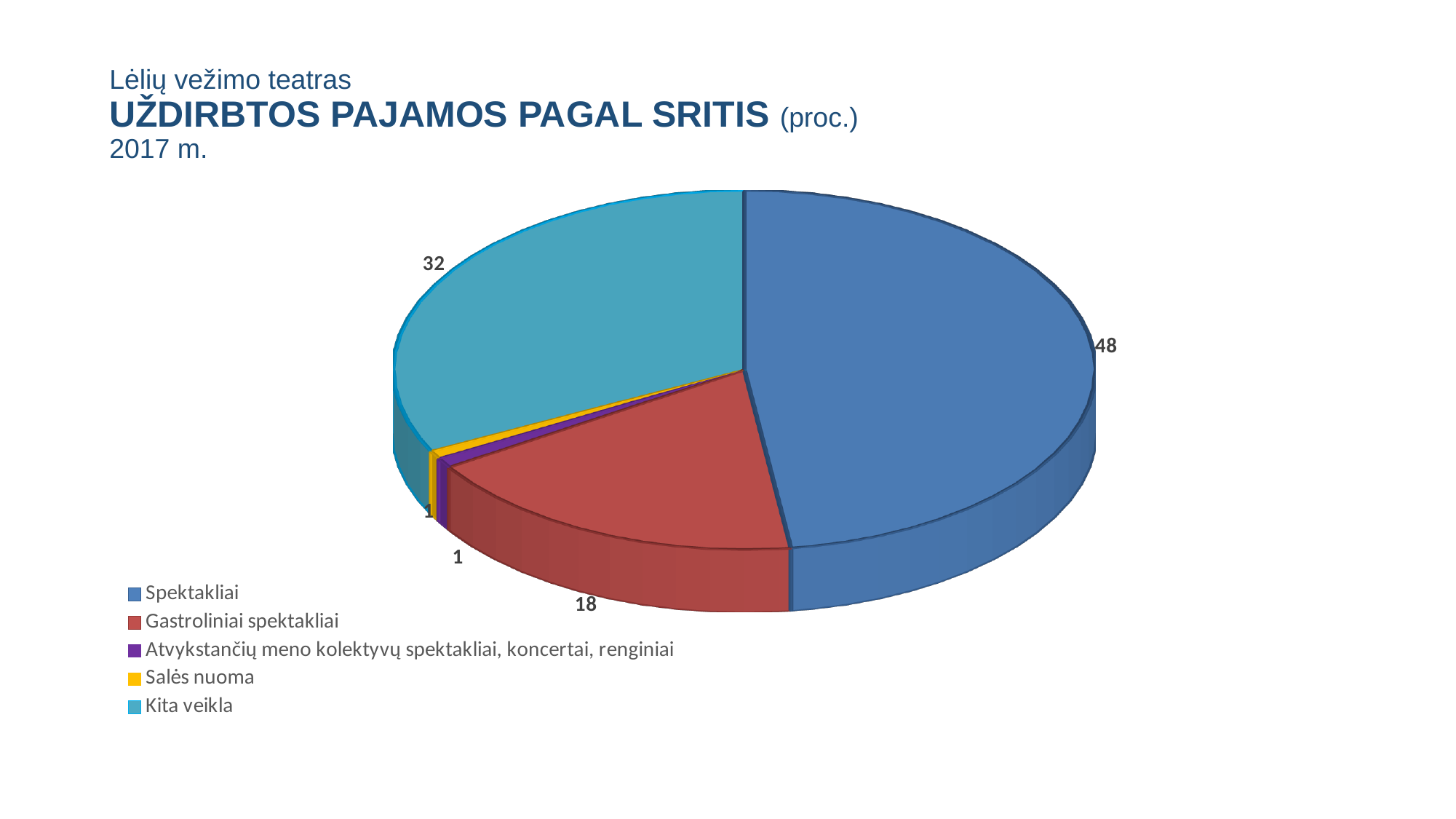
How many categories does the legend list? 5 What is the difference between the values for Spektakliai and Kita veikla? 16 What year does the chart title refer to? 2017 m. What is the value shown for Spektakliai? 48 What kind of chart is shown on the slide? pie chart Which category has the largest slice of the pie? Spektakliai What is the value shown for Kita veikla? 32 Which is larger, Kita veikla or Gastroliniai spektakliai? Kita veikla What is the value shown for Salės nuoma? 1 What is the difference between the values for Kita veikla and Gastroliniai spektakliai? 14 What is the value shown for Gastroliniai spektakliai? 18 Which legend entry is shown in yellow? Salės nuoma